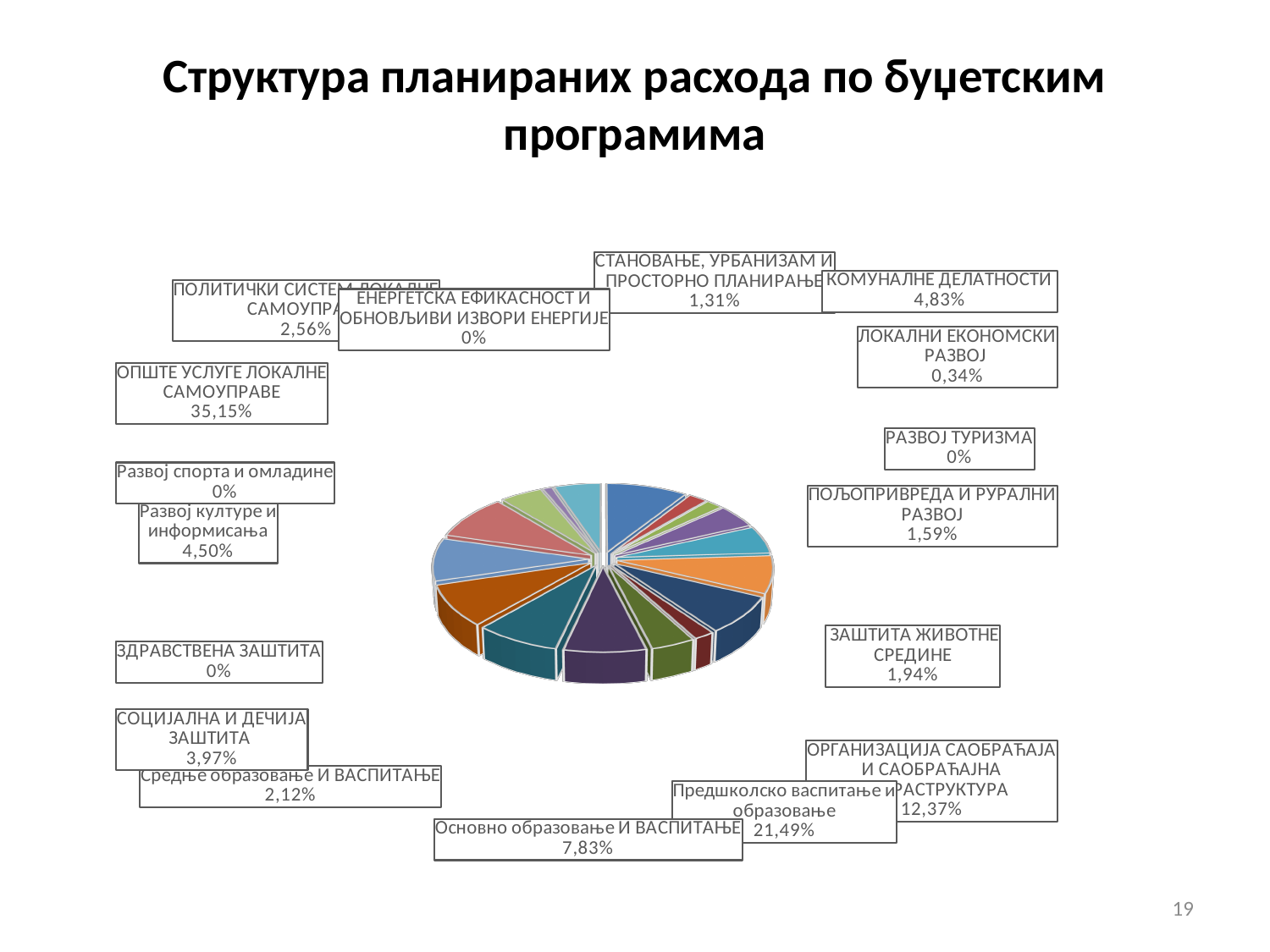
Which budget program has the largest share of planned expenditure? ОПШТЕ УСЛУГЕ ЛОКАЛНЕ САМОУПРАВЕ What share is shown for КОМУНАЛНЕ ДЕЛАТНОСТИ? 4,83% What share is shown for РАЗВОЈ ТУРИЗМА? 0% What type of chart is shown on the slide? pie chart What is the title of the chart on the slide? Структура планираних расхода по буџетским програмима Which has the larger share: Основно образовање И ВАСПИТАЊЕ or Средње образовање И ВАСПИТАЊЕ? Основно образовање И ВАСПИТАЊЕ What share is shown for Предшколско васпитање и образовање? 21,49% What is the difference in percentage points between ОПШТЕ УСЛУГЕ ЛОКАЛНЕ САМОУПРАВЕ and Предшколско васпитање и образовање? 13,66 What share is shown for ОРГАНИЗАЦИЈА САОБРАЋАЈА И САОБРАЋАЈНА ИНФРАСТРУКТУРА? 12,37% What share is shown for ЗАШТИТА ЖИВОТНЕ СРЕДИНЕ? 1,94% What share of planned expenditure goes to ОПШТЕ УСЛУГЕ ЛОКАЛНЕ САМОУПРАВЕ? 35,15% What share is shown for ЛОКАЛНИ ЕКОНОМСКИ РАЗВОЈ? 0,34%